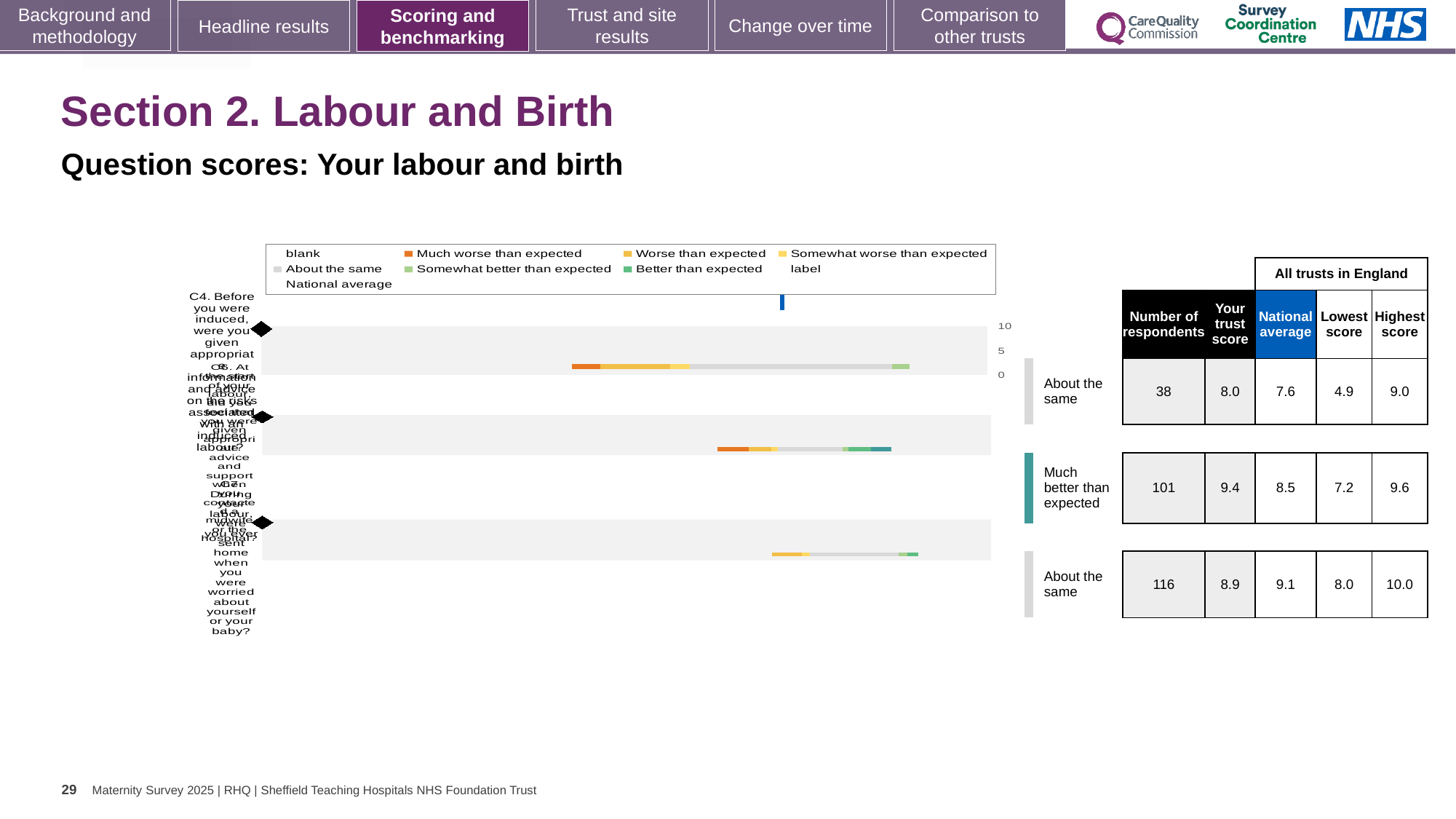
In the table row labelled 'Much better than expected', which is larger: the trust score or the national average? the trust score In the table, what is the national average for the first row (38 respondents)? 7.6 What kind of chart is shown on the slide? bar chart How many question rows (bars) does the chart show? 3 In the table, what is the smallest 'Lowest score' value shown? 4.9 In the table row labelled 'Much better than expected', what is the difference between the trust score and the national average? 0.9 In the table, which row has the largest number of respondents? the third row (116) In the table, what is the number of respondents for the row labelled 'Much better than expected'? 101 In the table, what is the trust score for the row labelled 'Much better than expected'? 9.4 In the table, what is the highest score for the third row (116 respondents)? 10.0 In the legend, what colour represents 'Much worse than expected'? orange In the legend, what colour represents 'Better than expected'? teal